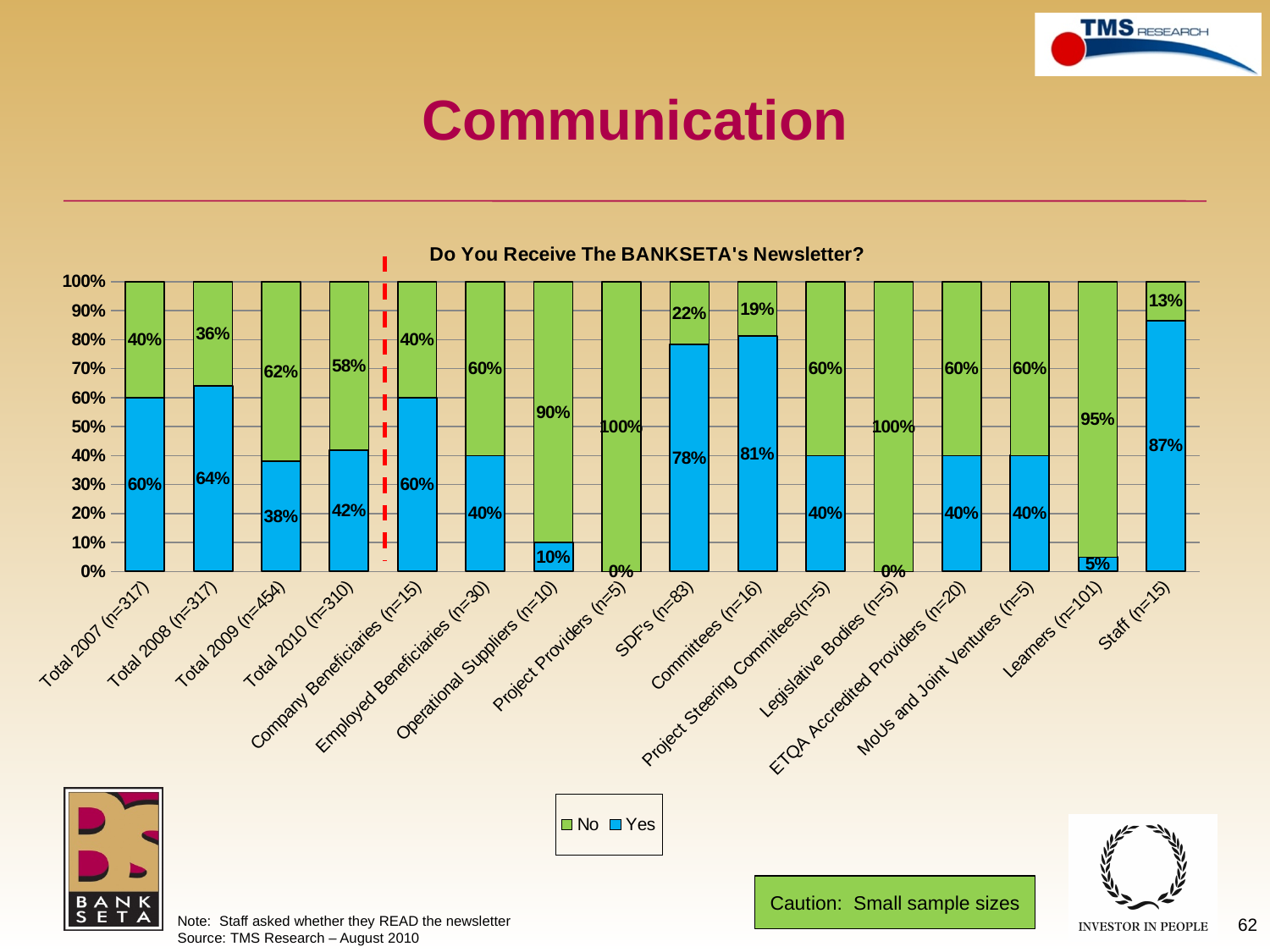
Which is larger, the 'Yes' value for SDF's (n=83) or the 'Yes' value for Committees (n=16)? Committees (n=16) What is the 'Yes' value for Total 2009 (n=454)? 38% How many series does the legend list? 2 What is the 'No' value for Learners (n=101)? 95% What is the 'Yes' value for Staff (n=15)? 87% How many categories are shown on the x axis of the chart? 16 Which category has the highest 'Yes' value? Staff (n=15) What is the title of the chart? Do You Receive The BANKSETA's Newsletter? What type of chart is shown on the slide? Stacked bar chart Which category has the lowest 'No' value? Staff (n=15) Does the 'Yes' value rise or fall from Total 2008 (n=317) to Total 2009 (n=454)? Fall What is the difference between the 'Yes' values for Total 2008 (n=317) and Total 2010 (n=310)? 22%